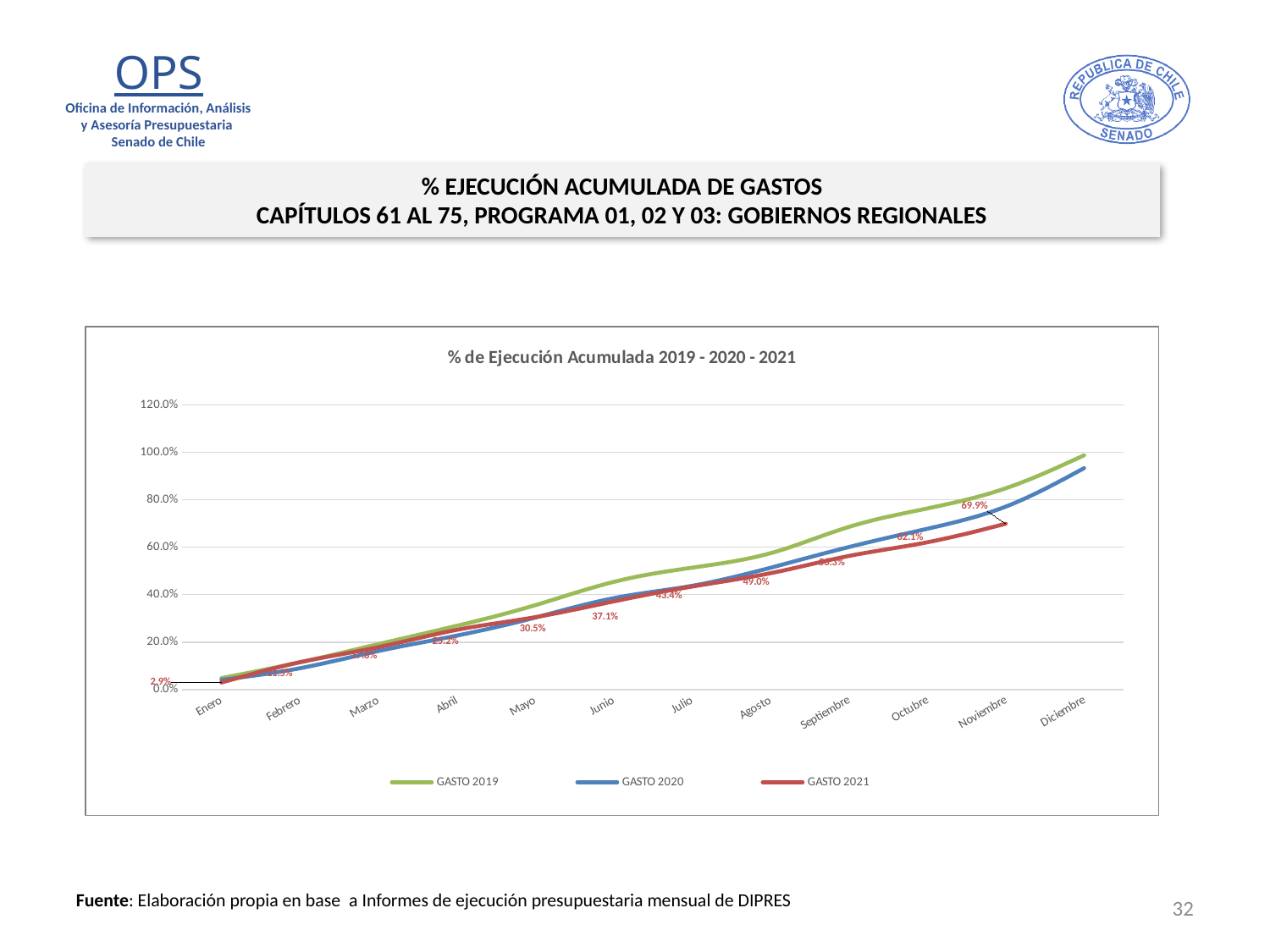
What is the value of GASTO 2021 in Agosto? 49.0% What is the difference between the GASTO 2021 values for Noviembre and Agosto? 20.9 percentage points Do the values of GASTO 2021 rise or fall from Enero to Noviembre? rise What is the value of GASTO 2021 in Noviembre? 69.9% How many series does the chart legend list? 3 What kind of chart is shown on the slide? line chart What is the value of GASTO 2021 in Junio? 37.1% Which series has the higher value in Diciembre, GASTO 2019 or GASTO 2020? GASTO 2019 What is the value of GASTO 2021 in Mayo? 30.5% How many months are plotted along the x axis of the chart? 12 Is the value of GASTO 2019 in Diciembre greater or less than 80.0%? greater What is the title of the chart? % de Ejecución Acumulada 2019 - 2020 - 2021